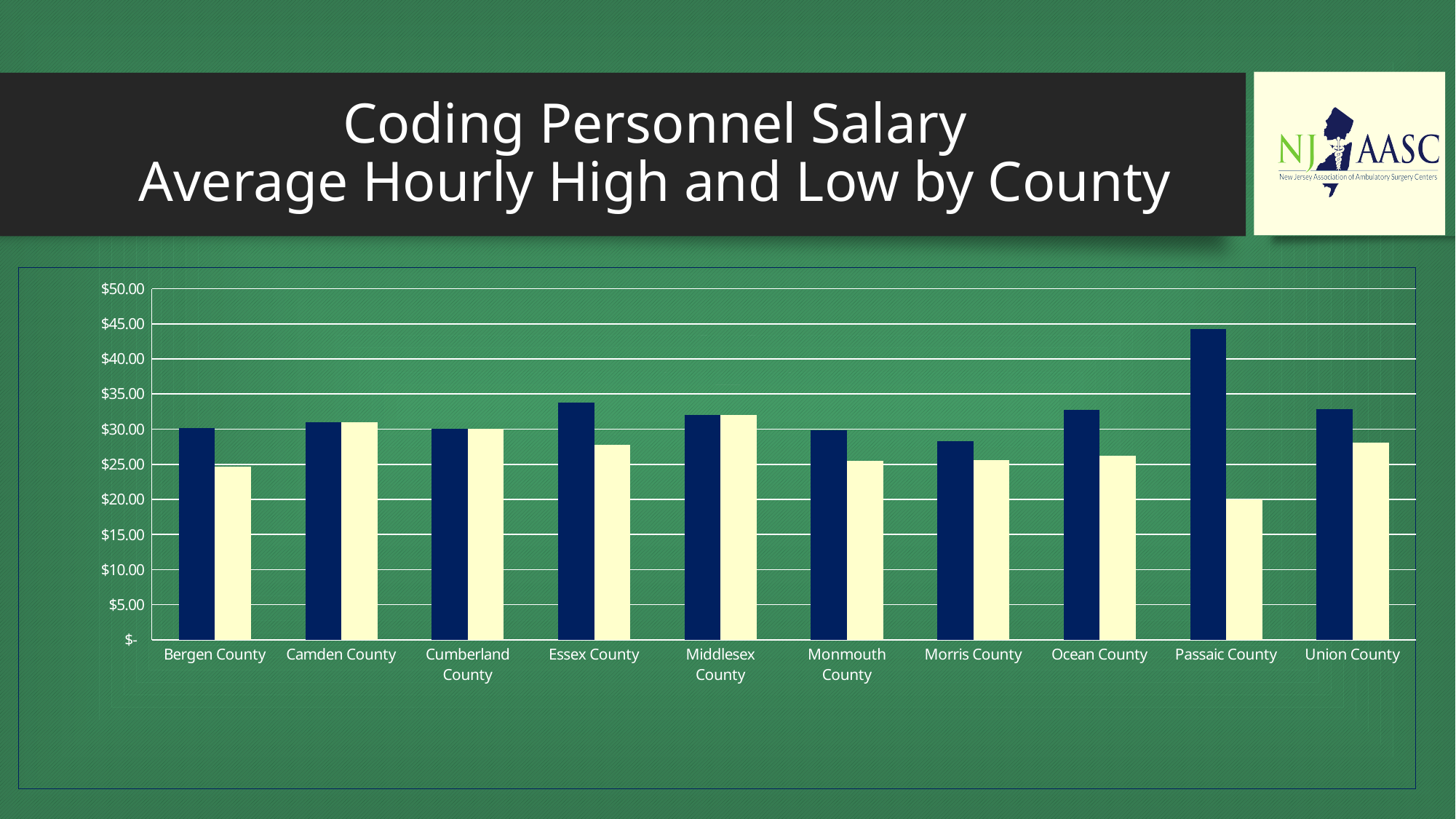
Is the dark blue bar for Morris County greater or less than $30.00? less Which is larger, the light yellow bar for Bergen County or the light yellow bar for Camden County? Camden County Is the light yellow bar for Essex County greater or less than $30.00? less Which county has the tallest dark blue bar? Passaic County What is the title of the slide containing the chart? Coding Personnel Salary Average Hourly High and Low by County What kind of chart is shown on the slide? bar chart Is the dark blue bar for Passaic County greater or less than $40.00? greater Which county has the shortest dark blue bar? Morris County Which county has the shortest light yellow bar? Passaic County Which is larger, the dark blue bar for Essex County or the dark blue bar for Morris County? Essex County How many counties are shown on the x axis of the chart? 10